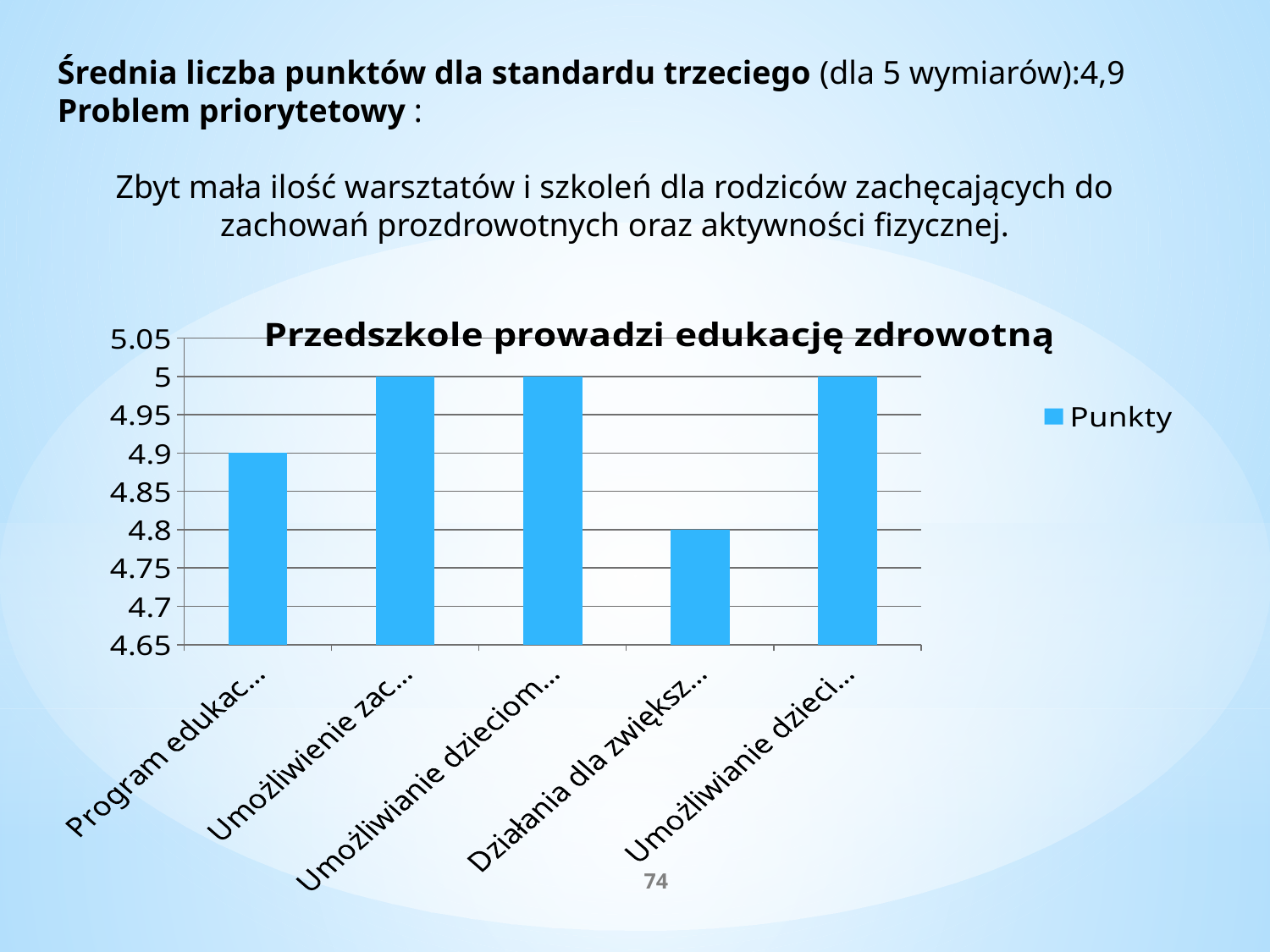
What is the value of the second bar ("Umożliwienie zac...")? 5 What type of chart is shown on the slide? bar chart What is the name of the series shown in the legend? Punkty Which bar has the lowest value? the fourth bar ("Działania dla zwiększ...") How many bars (categories) are plotted in the chart? 5 What is the difference between the value of the first bar and the value of the fourth bar? 0.1 How many bars reach the value 5? 3 How many series does the chart legend list? 1 Which is larger: the value of the first bar ("Program edukac...") or the fourth bar ("Działania dla zwiększ...")? the first bar ("Program edukac...") What is the value of the fourth bar ("Działania dla zwiększ...")? 4.8 What is the value of the first bar ("Program edukac...")? 4.9 What is the title of the chart? Przedszkole prowadzi edukację zdrowotną